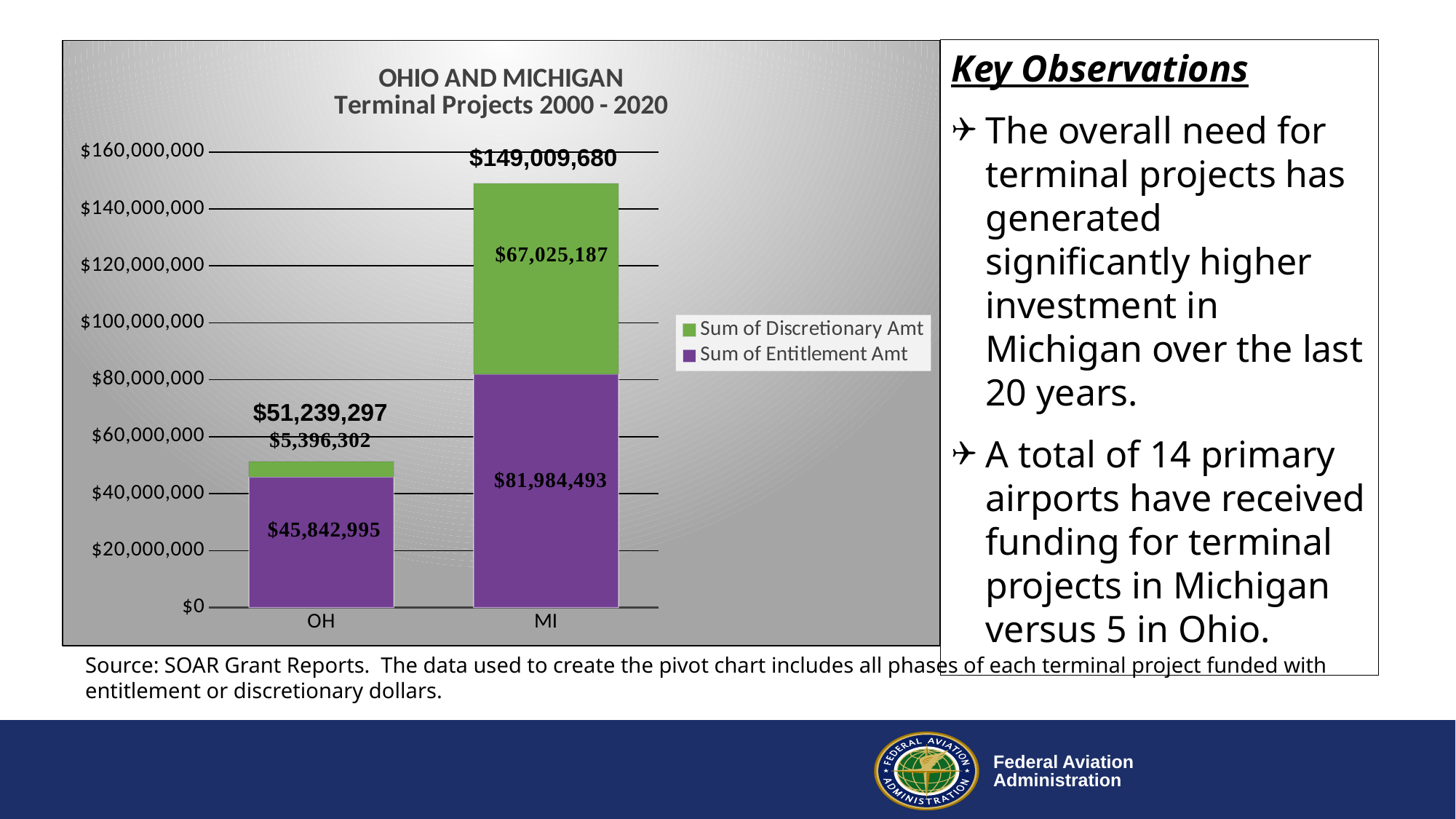
How many series does the legend list? 2 What is the Sum of Discretionary Amt for OH? $5,396,302 Which state has the higher total for terminal projects? MI What is the Sum of Entitlement Amt for OH? $45,842,995 Is the total for OH greater or less than $60,000,000? less What is the Sum of Discretionary Amt for MI? $67,025,187 What is the Sum of Entitlement Amt for MI? $81,984,493 What is the difference between the Sum of Entitlement Amt for MI and for OH? $36,141,498 What is the difference between the MI total and the OH total? $97,770,383 What kind of chart is shown on the slide? Stacked bar chart What is the total of the stacked bar for OH? $51,239,297 What is the total of the stacked bar for MI? $149,009,680